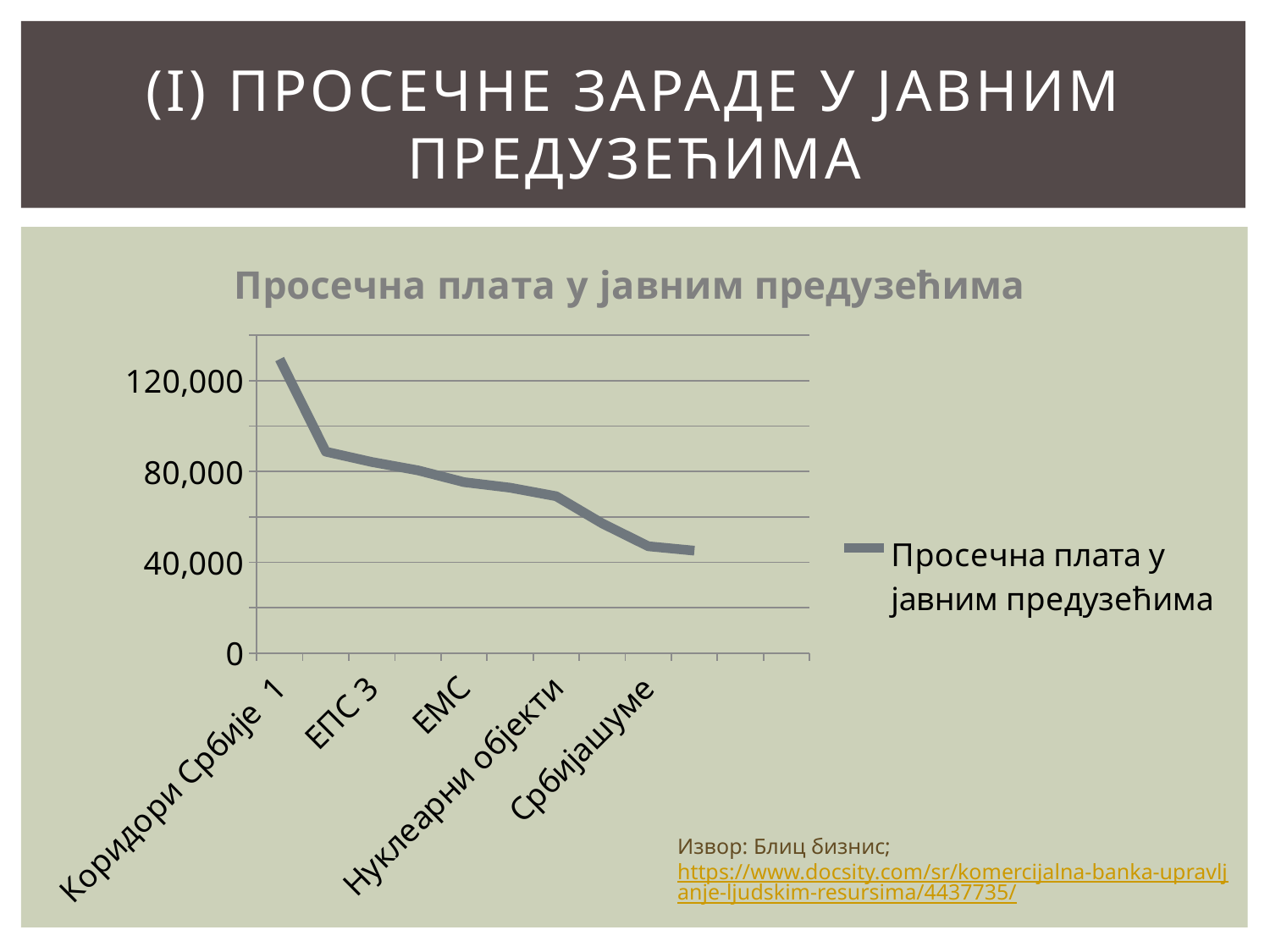
Which category has the highest average salary in the chart? Коридори Србије 1 Which is larger, the value for Коридори Србије 1 or the value for ЕПС 3? Коридори Србије 1 Which is larger, the value for ЕМС or the value for Србијашуме? ЕМС Is the value for Коридори Србије 1 greater or less than 120,000? greater Is the value for ЕПС 3 greater or less than 80,000? greater What is the title of the chart? Просечна плата у јавним предузећима What kind of chart is shown on the slide? line chart Is the value for ЕМС greater or less than 80,000? less Do the values rise or fall moving from left to right along the x axis? fall How many series does the legend list? 1